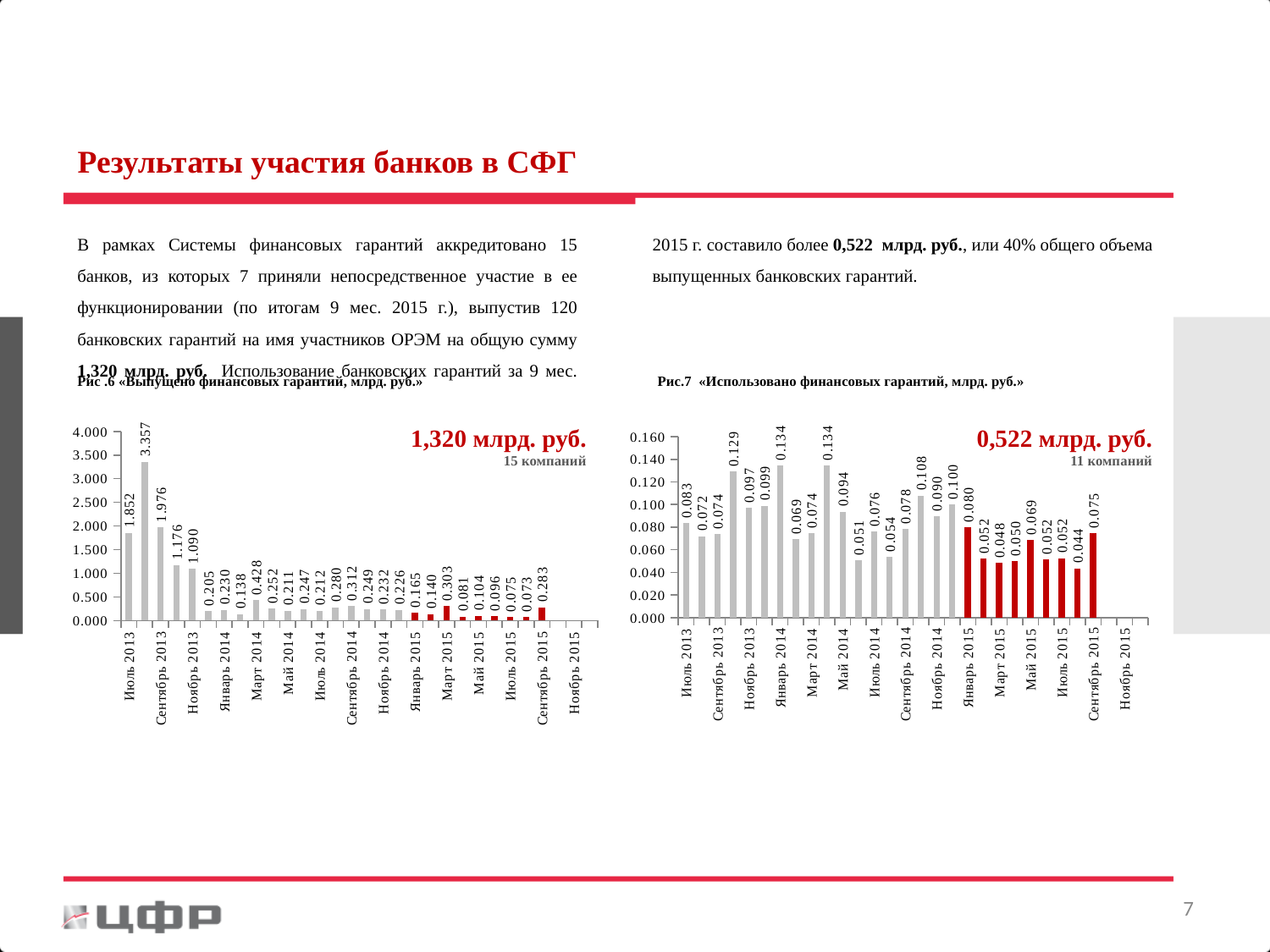
In the chart Рис.6 «Выпущено финансовых гарантий, млрд. руб.», what is the highest value shown on any bar? 3.357 In the chart Рис.6 «Выпущено финансовых гарантий, млрд. руб.», what is the difference between the values for Сентябрь 2013 and Июль 2013? 0.124 What kind of chart is Рис.6 «Выпущено финансовых гарантий, млрд. руб.»? bar chart In the chart Рис.6 «Выпущено финансовых гарантий, млрд. руб.», do the values generally rise or fall from 2013 to 2015? fall How many companies are noted under the total in the chart Рис.7 «Использовано финансовых гарантий, млрд. руб.»? 11 компаний In the chart Рис.6 «Выпущено финансовых гарантий, млрд. руб.», what is the value for Сентябрь 2013? 1.976 In the chart Рис.6 «Выпущено финансовых гарантий, млрд. руб.», what is the value for Июль 2013? 1.852 What total amount is printed in large text on the chart Рис.6 «Выпущено финансовых гарантий, млрд. руб.»? 1,320 млрд. руб. In the chart Рис.7 «Использовано финансовых гарантий, млрд. руб.», what is the value for Июль 2013? 0.083 In the chart Рис.7 «Использовано финансовых гарантий, млрд. руб.», what is the lowest value shown on any bar? 0.044 In the chart Рис.6 «Выпущено финансовых гарантий, млрд. руб.», which is larger, the value for Июль 2013 or the value for Сентябрь 2013? Сентябрь 2013 In the chart Рис.7 «Использовано финансовых гарантий, млрд. руб.», what is the value for Январь 2015? 0.080